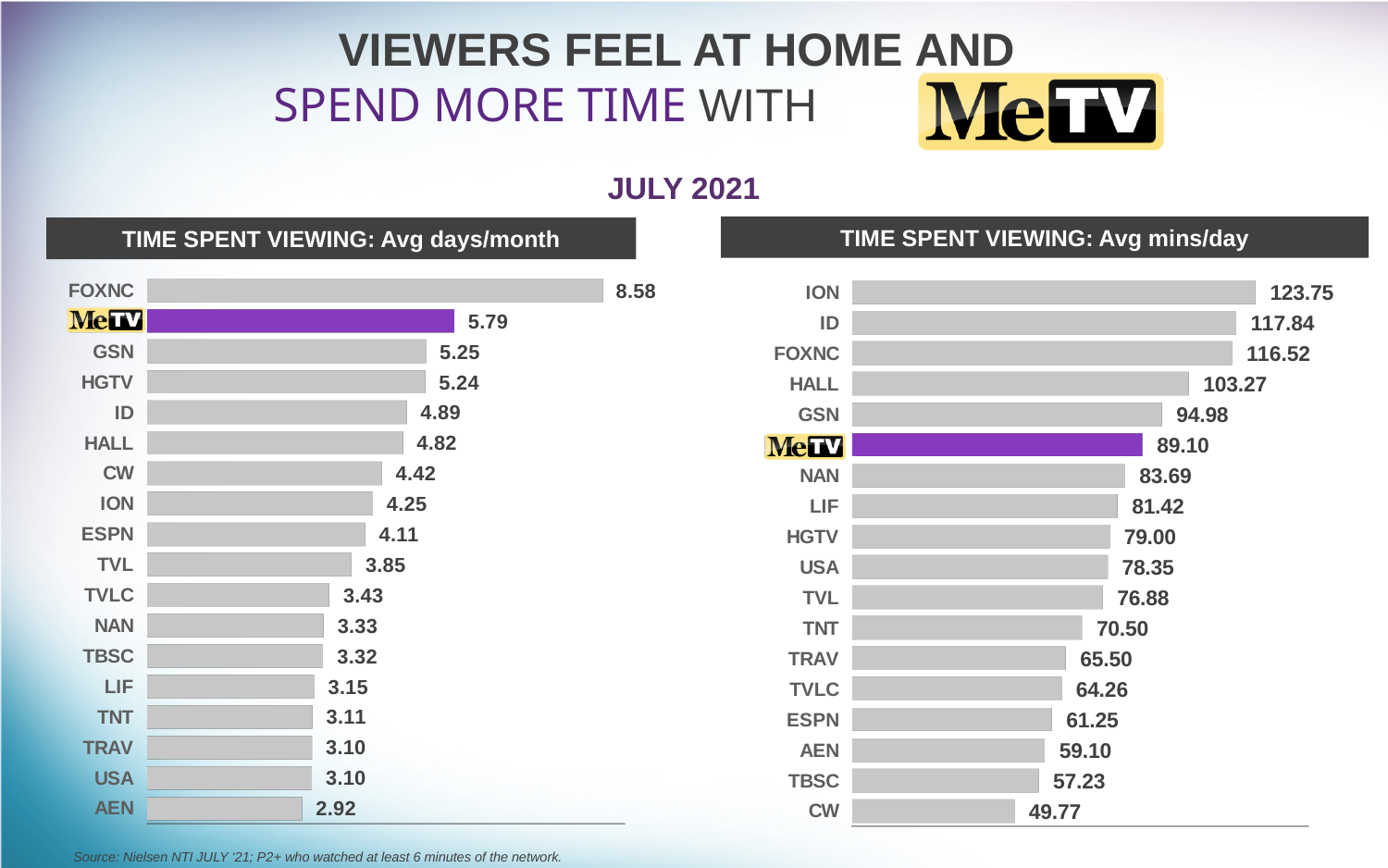
In the 'TIME SPENT VIEWING: Avg days/month' chart, what is the value for AEN? 2.92 In the 'TIME SPENT VIEWING: Avg mins/day' chart, what is the value for HALL? 103.27 In the 'TIME SPENT VIEWING: Avg days/month' chart, which network has the highest value? FOXNC In the 'TIME SPENT VIEWING: Avg mins/day' chart, what is the difference between ION and MeTV? 34.65 In the 'TIME SPENT VIEWING: Avg days/month' chart, what is the difference between FOXNC and MeTV? 2.79 In the 'TIME SPENT VIEWING: Avg days/month' chart, which is larger, the value for CW or the value for TVL? CW In the 'TIME SPENT VIEWING: Avg mins/day' chart, which network has the lowest value? CW In the 'TIME SPENT VIEWING: Avg mins/day' chart, which bar is highlighted in purple? MeTV In the 'TIME SPENT VIEWING: Avg days/month' chart, what is the value for MeTV? 5.79 In the 'TIME SPENT VIEWING: Avg mins/day' chart, which is larger, the value for GSN or the value for NAN? GSN What kind of chart is the 'TIME SPENT VIEWING: Avg days/month' chart? Bar chart How many networks are shown in the 'TIME SPENT VIEWING: Avg mins/day' chart? 18